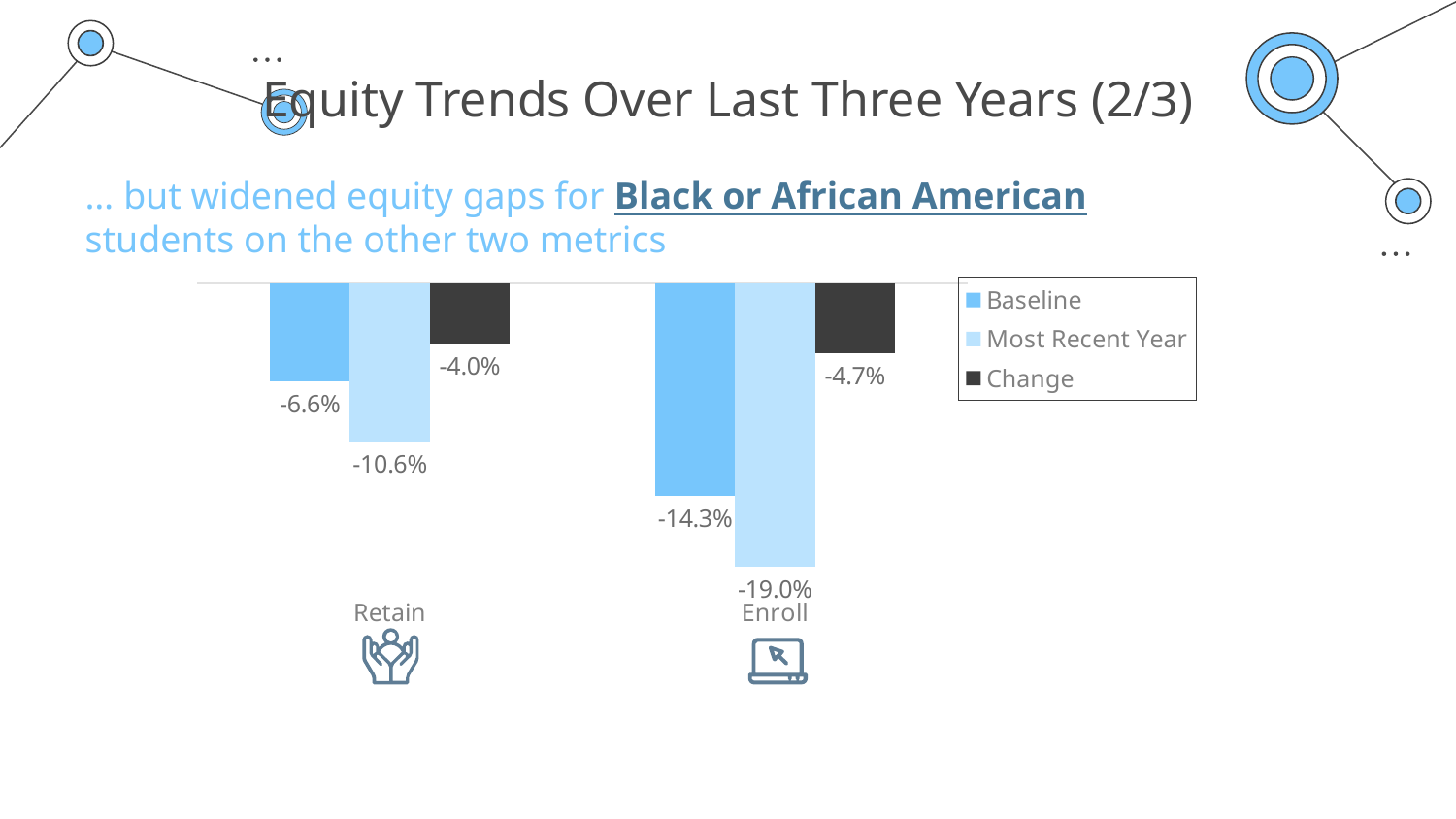
What is the Baseline value for Retain? -6.6% What is the Most Recent Year value for Enroll? -19.0% How many categories are shown on the x axis? 2 Which category has the lowest Most Recent Year value? Enroll What is the Change value for Enroll? -4.7% What kind of chart is shown on the slide? Bar chart Which is larger, the Baseline value for Retain or the Baseline value for Enroll? Retain Which series is shown in dark grey in the legend? Change How many series does the legend list? 3 What is the Change value for Retain? -4.0% What is the difference between the Baseline and Most Recent Year values for Retain? 4.0% What is the Baseline value for Enroll? -14.3%